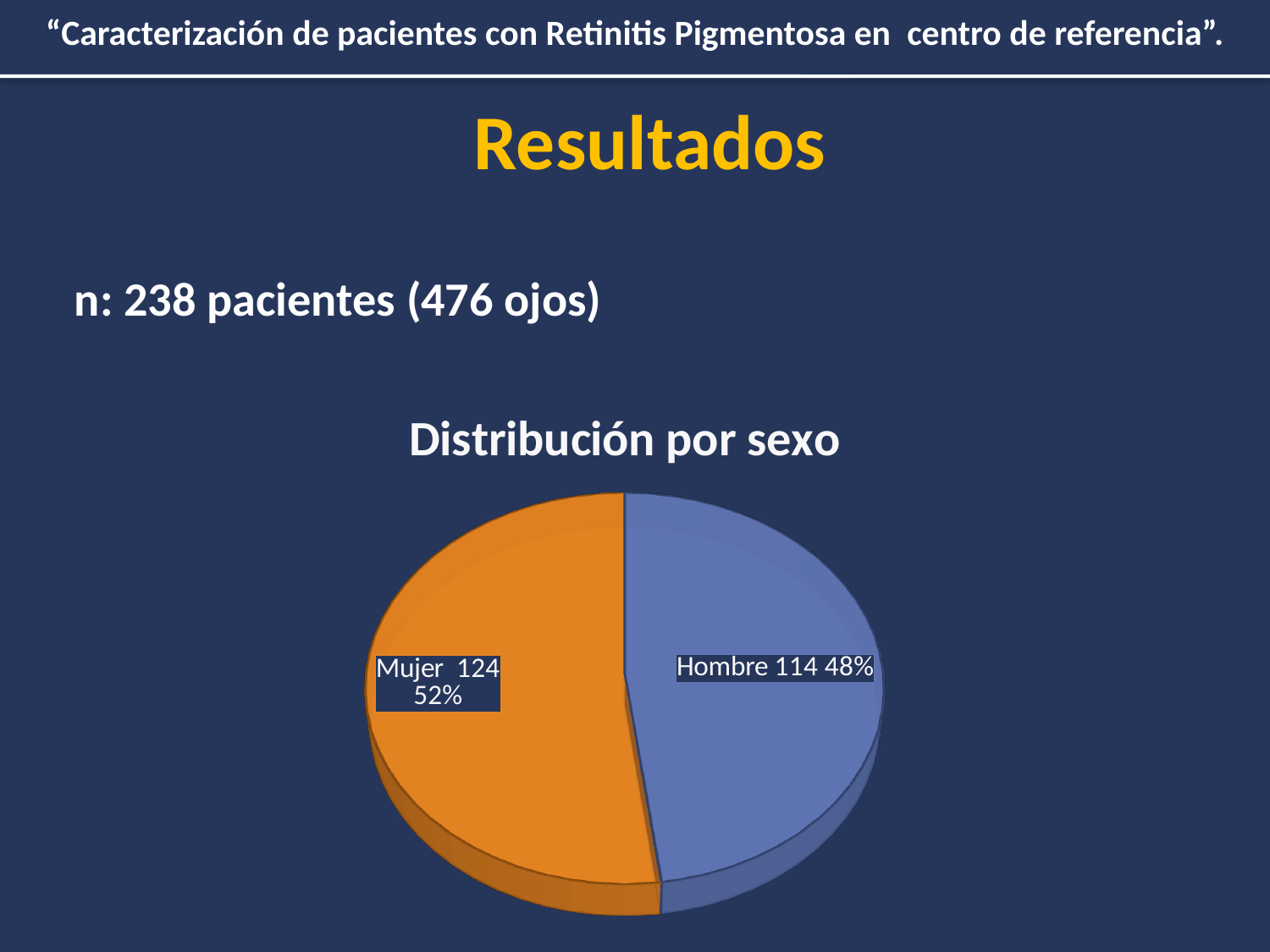
What kind of chart is shown under the title "Distribución por sexo"? pie chart What is the value for Mujer in the pie chart? 124 What is the title of the chart? Distribución por sexo Which category has the smallest slice in the pie chart? Hombre How many slices does the pie chart have? 2 What is the difference between the Mujer and Hombre values? 10 What percentage share does the Mujer slice have? 52% Which is larger, the value for Mujer or the value for Hombre? Mujer What percentage share does the Hombre slice have? 48% What is the value for Hombre in the pie chart? 114 Which category has the largest slice in the pie chart? Mujer What colour is the Hombre slice in the pie chart? blue